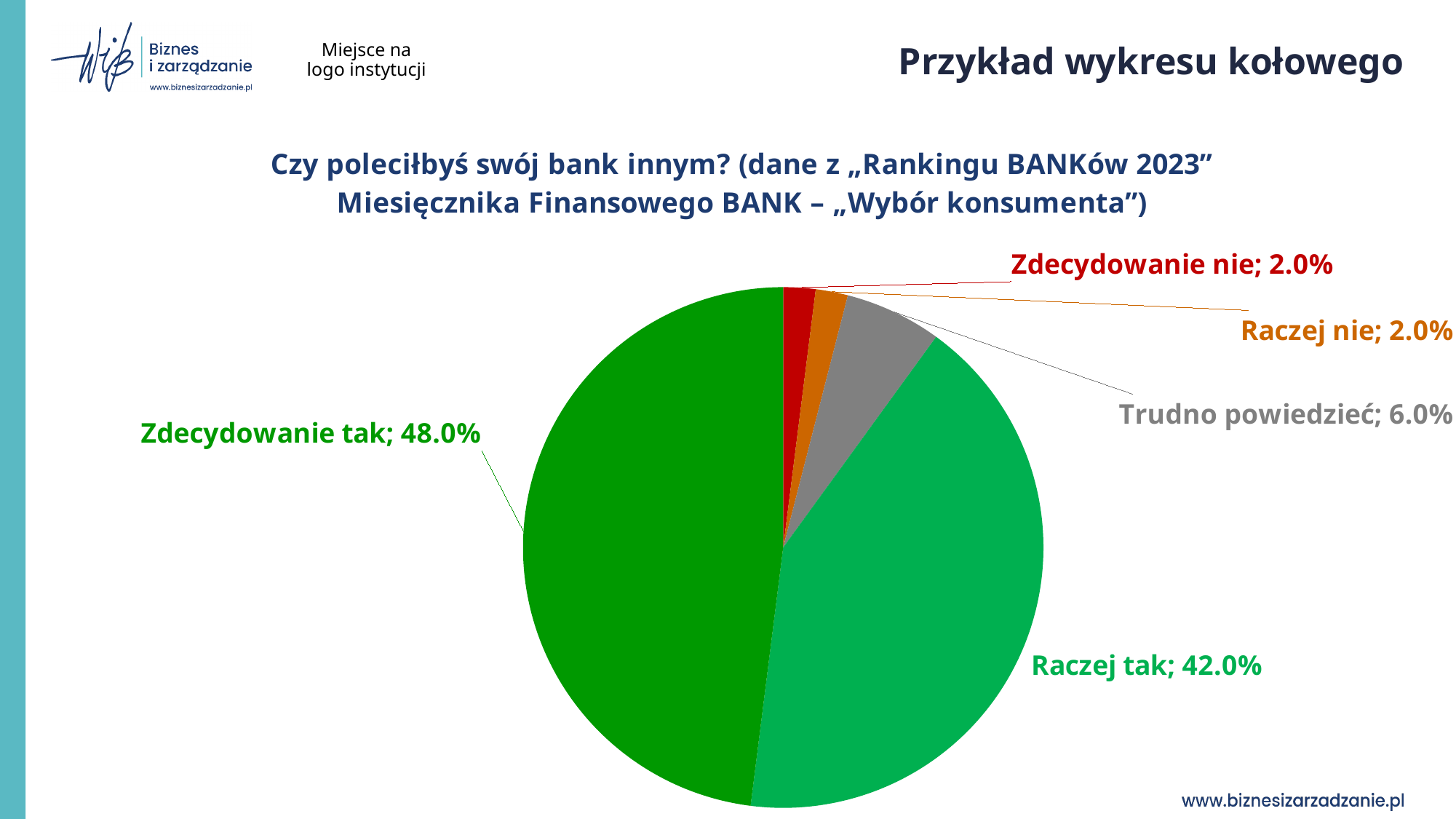
What is the combined value of "Zdecydowanie tak" and "Raczej tak"? 90.0% What share of the pie does "Zdecydowanie tak" have? 48.0% How many slices does the pie chart have? 5 What is the value for "Trudno powiedzieć"? 6.0% Which is larger, the value for "Trudno powiedzieć" or the value for "Raczej nie"? Trudno powiedzieć Which category has the largest slice of the pie? Zdecydowanie tak What is the title of the slide? Przykład wykresu kołowego What type of chart is shown on the slide? pie chart What is the difference between the values for "Zdecydowanie tak" and "Raczej tak"? 6.0% What colour is the "Zdecydowanie nie" slice? red What is the value for "Zdecydowanie nie"? 2.0% What is the value for "Raczej tak"? 42.0%